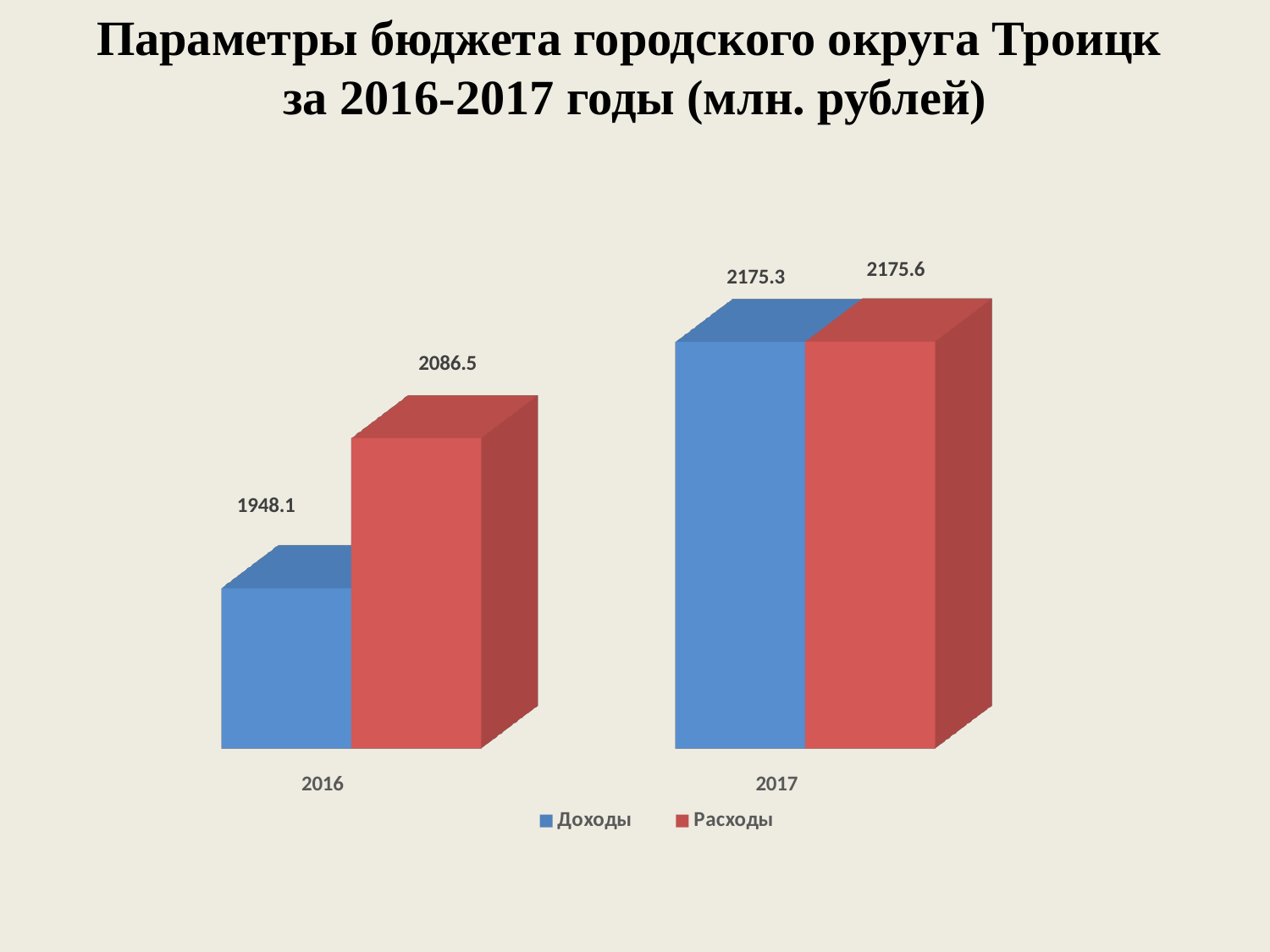
By how much did Доходы increase from 2016 to 2017? 227.2 What is the value of Доходы for 2017? 2175.3 What is the value of Расходы for 2016? 2086.5 How many years (categories) are shown on the x axis? 2 Which is larger for 2016, Доходы or Расходы? Расходы How many series does the legend list? 2 What is the difference between Расходы and Доходы for 2016? 138.4 Which bar has the lowest value on the chart? Доходы for 2016 What kind of chart is shown on the slide? Bar chart Which bar has the highest value on the chart? Расходы for 2017 What is the value of Доходы for 2016? 1948.1 What is the value of Расходы for 2017? 2175.6